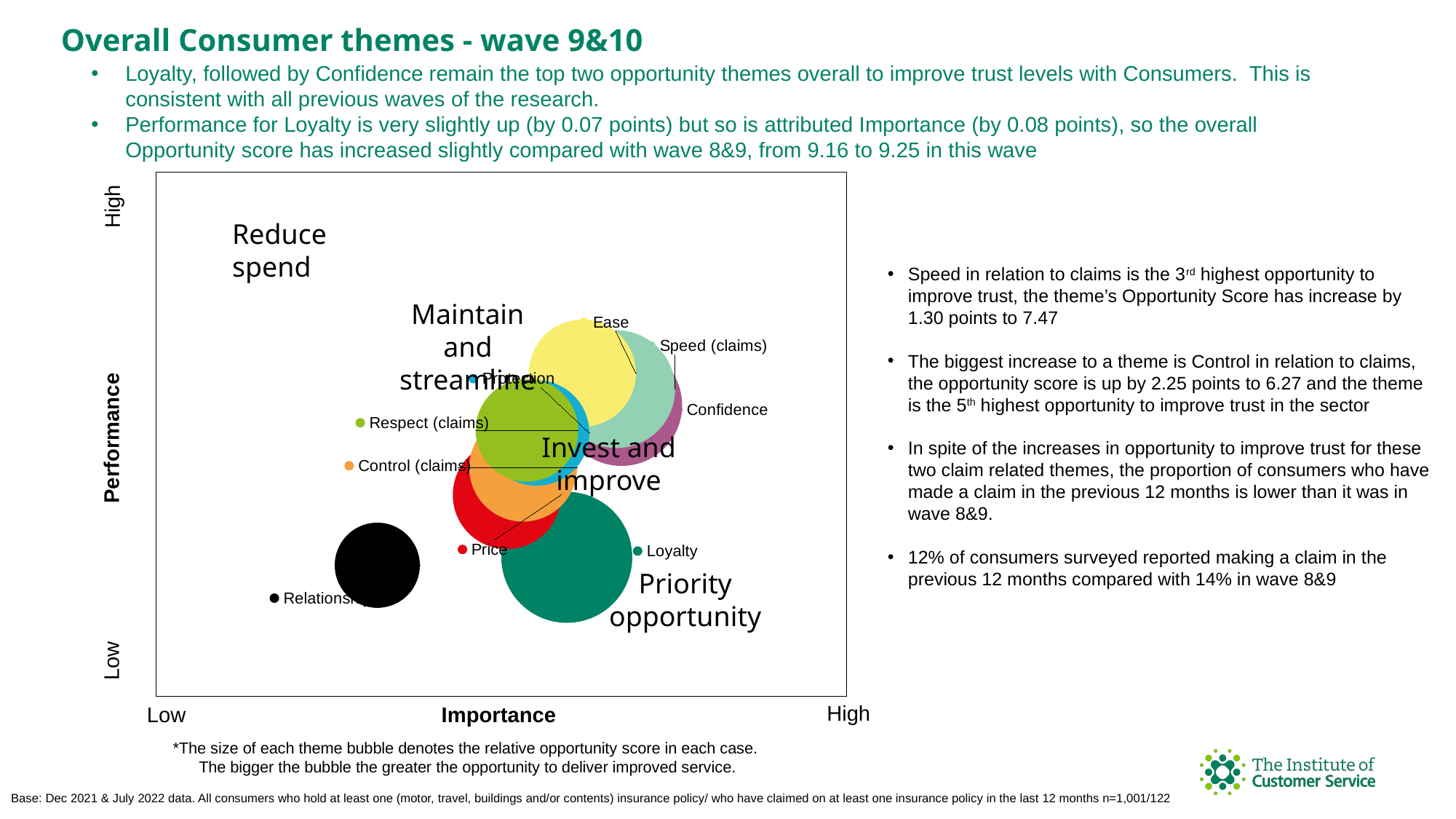
What is the label of the horizontal axis of the chart? Importance What kind of chart is shown on the slide? Bubble chart Which theme has the higher Performance, Ease or Price? Ease Which theme is plotted highest on the Performance axis? Ease Which theme has the higher Importance, Loyalty or Relationship? Loyalty Which theme has the largest bubble on the chart? Loyalty Which theme is plotted lowest on the Performance axis? Relationship Which theme is plotted furthest to the left (lowest Importance)? Relationship How many theme bubbles are plotted on the chart? 9 Which quadrant label appears in the bottom-right of the chart? Priority opportunity Which theme has the larger bubble, Loyalty or Respect (claims)? Loyalty